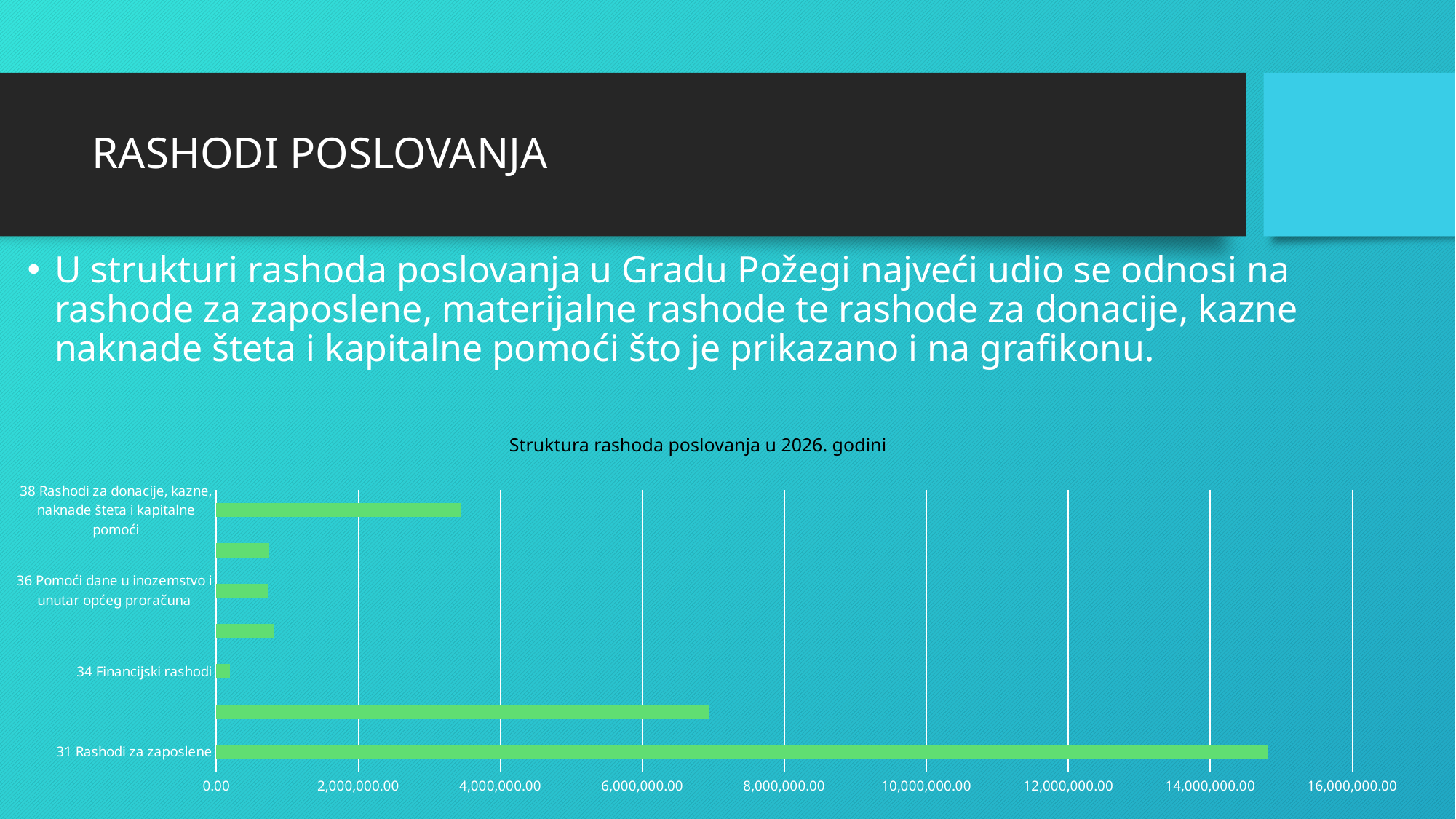
Which labelled category has the lowest value in the chart? 34 Financijski rashodi Which is larger: the value for 38 Rashodi za donacije, kazne, naknade šteta i kapitalne pomoći or the value for 36 Pomoći dane u inozemstvo i unutar općeg proračuna? 38 Rashodi za donacije, kazne, naknade šteta i kapitalne pomoći What is the highest value shown on the horizontal axis of the chart? 16,000,000.00 Is the value for 31 Rashodi za zaposlene greater or less than 14,000,000.00? greater What kind of chart is shown on the slide? bar chart What is the title of the chart? Struktura rashoda poslovanja u 2026. godini Is the value for 36 Pomoći dane u inozemstvo i unutar općeg proračuna greater or less than 2,000,000.00? less Is the value for 34 Financijski rashodi greater or less than 2,000,000.00? less Which is larger: the value for 31 Rashodi za zaposlene or the value for 34 Financijski rashodi? 31 Rashodi za zaposlene Which category has the highest value in the chart? 31 Rashodi za zaposlene